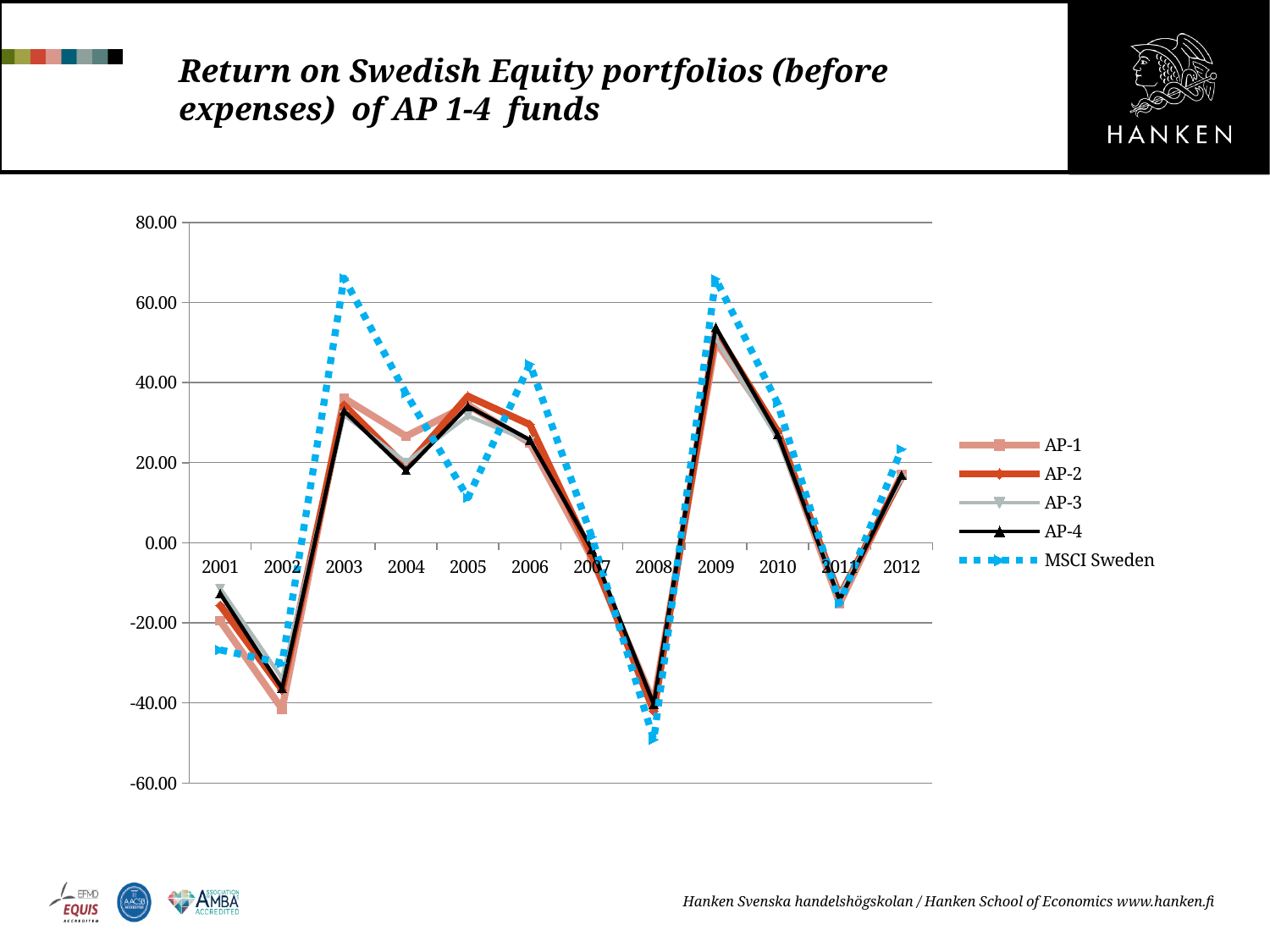
In which year is the MSCI Sweden value lowest? 2008 Is the value for MSCI Sweden in 2008 greater or less than -40.00? less How many series does the legend list? 5 Is the value for AP-4 in 2009 greater or less than 40.00? greater How many years are plotted along the x axis? 12 In 2005, which is larger: the value for AP-4 or the value for MSCI Sweden? AP-4 What kind of chart is shown on the slide? line chart Which series is drawn with a dotted line? MSCI Sweden Is the value for MSCI Sweden in 2003 greater or less than 60.00? greater Between 2009 and 2011, does the AP-4 line rise or fall? fall In 2003, which is larger: the value for MSCI Sweden or the value for AP-4? MSCI Sweden